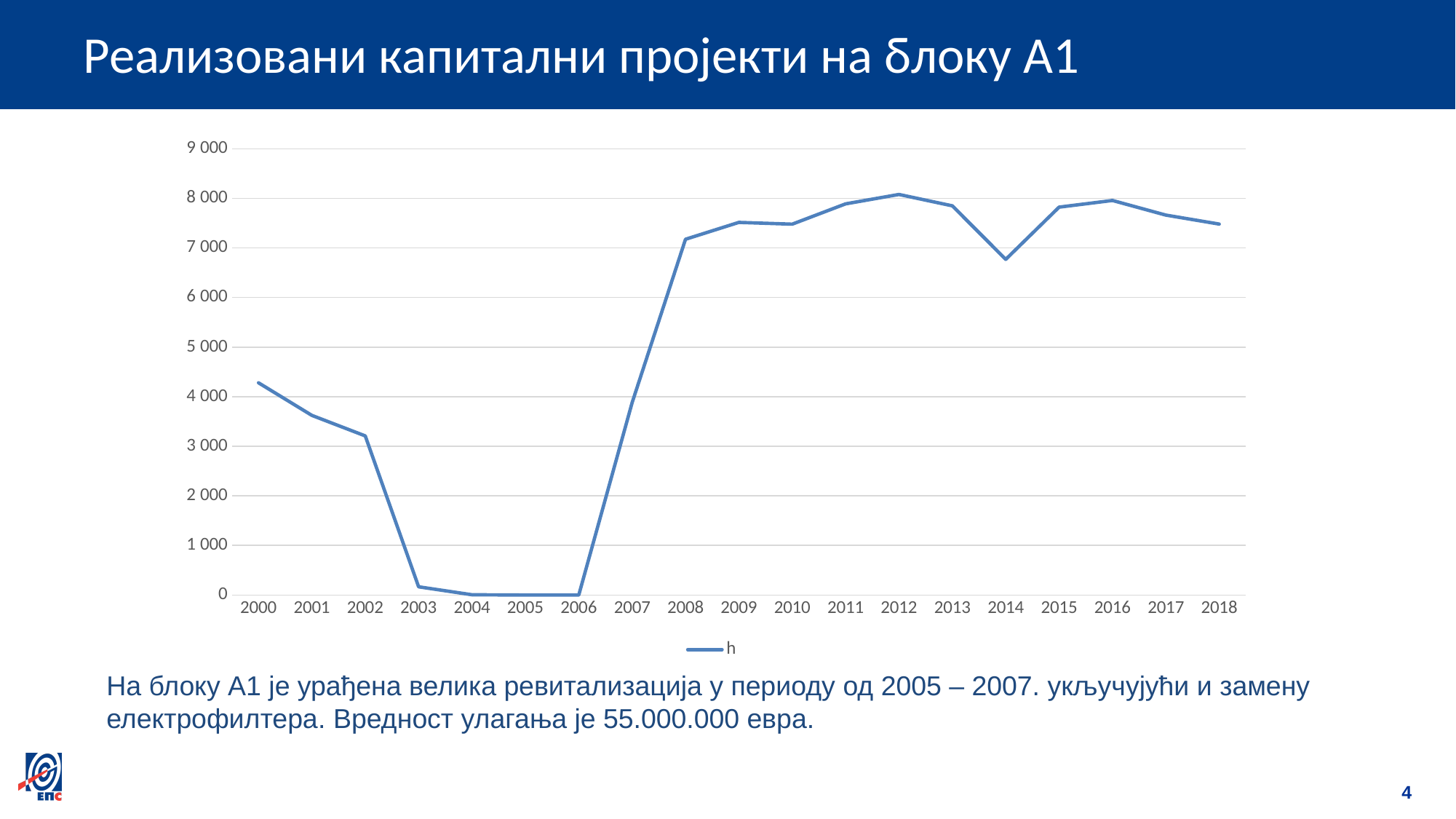
Which is larger, the value for 2000 or the value for 2002? 2000 Which is larger, the value for 2014 or the value for 2015? 2015 How many years are plotted along the x axis? 19 Do the values rise or fall from 2006 to 2008? rise Is the value for 2003 greater or less than 1 000? less How many series does the legend list? 1 Do the values rise or fall from 2000 to 2003? fall Is the value for 2014 greater or less than 7 000? less Is the value for 2000 greater or less than 4 000? greater What kind of chart is shown on the slide? line chart What is the legend entry for the plotted series? h